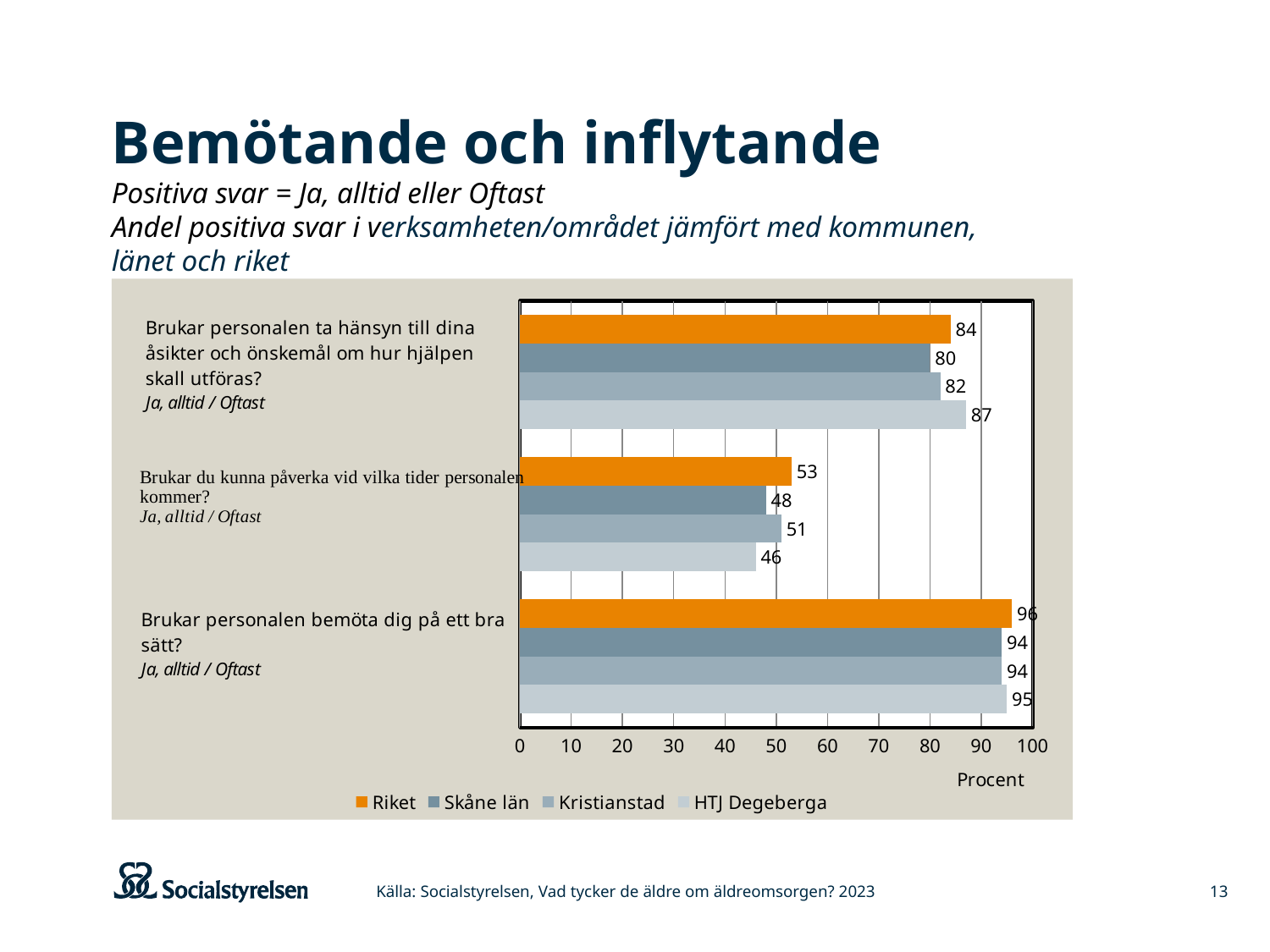
Which series has the highest value on the question "Brukar personalen ta hänsyn till dina åsikter och önskemål om hur hjälpen skall utföras?"? HTJ Degeberga What is the label on the horizontal axis of the chart? Procent How many series does the legend list? 4 What is the difference between the HTJ Degeberga and Skåne län values on the question "Brukar personalen ta hänsyn till dina åsikter och önskemål om hur hjälpen skall utföras?"? 7 What is the value for Riket on the question "Brukar du kunna påverka vid vilka tider personalen kommer?"? 53 Which series has the lowest value on the question "Brukar du kunna påverka vid vilka tider personalen kommer?"? HTJ Degeberga On the question "Brukar personalen bemöta dig på ett bra sätt?", which is larger: the value for Riket or the value for HTJ Degeberga? Riket What is the value for Skåne län on the question "Brukar personalen bemöta dig på ett bra sätt?"? 94 What is the value for HTJ Degeberga on the question "Brukar personalen ta hänsyn till dina åsikter och önskemål om hur hjälpen skall utföras?"? 87 What kind of chart is shown on the slide? Bar chart What is the difference between the Riket and Skåne län values on the question "Brukar du kunna påverka vid vilka tider personalen kommer?"? 5 How many question categories are shown on the chart? 3